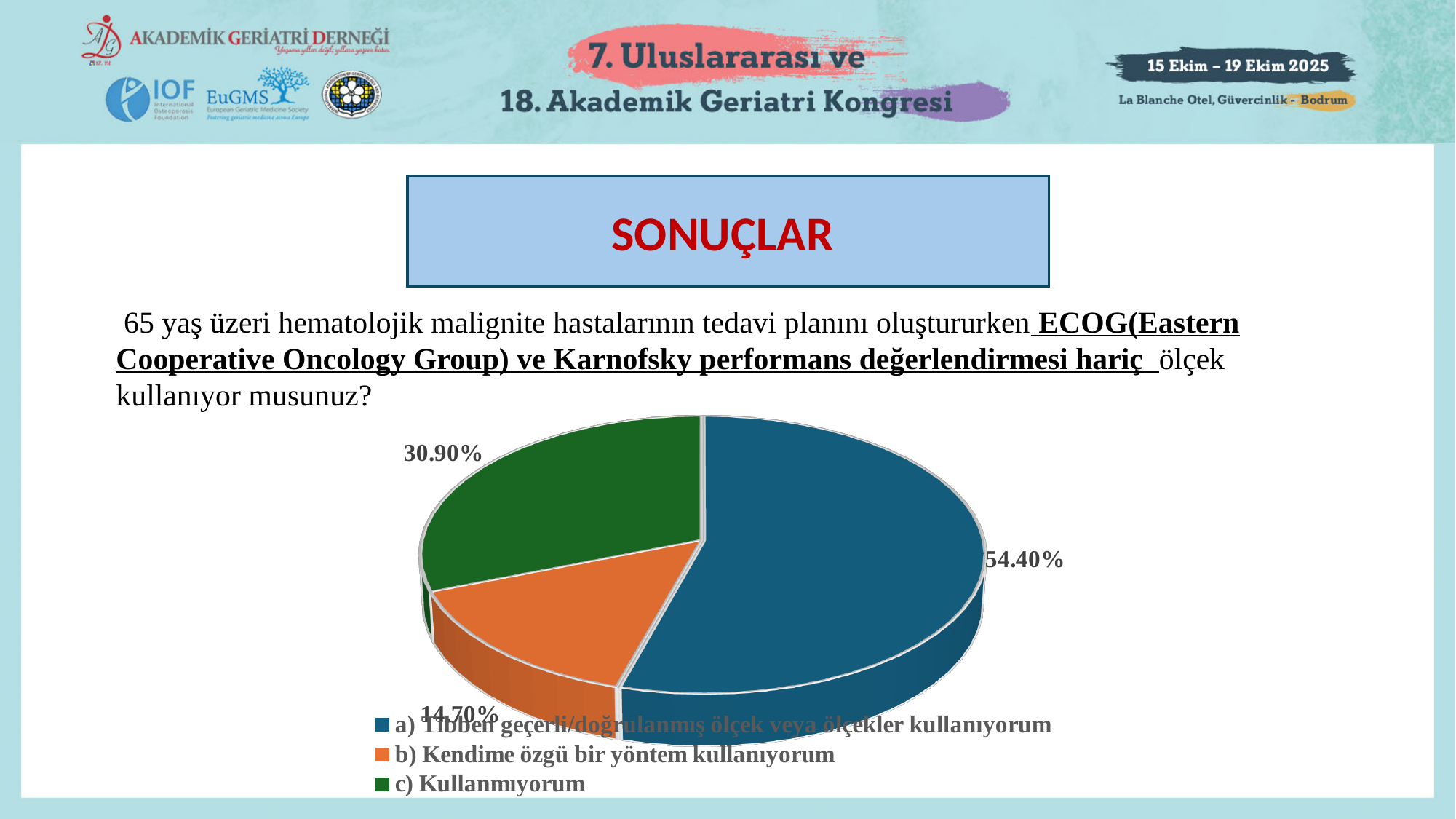
Which response option has the smallest share of the pie? b) Kendime özgü bir yöntem kullanıyorum How many entries does the legend list? 3 What is the difference in percentage points between option a) and option c)? 23.50% What is the difference in percentage points between option c) and option b)? 16.20% What percentage of respondents answered "b) Kendime özgü bir yöntem kullanıyorum"? 14.70% What percentage of respondents answered "c) Kullanmıyorum"? 30.90% How many slices does the pie chart have? 3 What kind of chart is shown on the slide? Pie chart Which is larger: the share for option c) Kullanmıyorum or option b) Kendime özgü bir yöntem kullanıyorum? c) Kullanmıyorum What colour is the slice for option c) Kullanmıyorum? Green What percentage of respondents answered "a) Tıbben geçerli/doğrulanmış ölçek veya ölçekler kullanıyorum"? 54.40% Which response option has the largest share of the pie? a) Tıbben geçerli/doğrulanmış ölçek veya ölçekler kullanıyorum